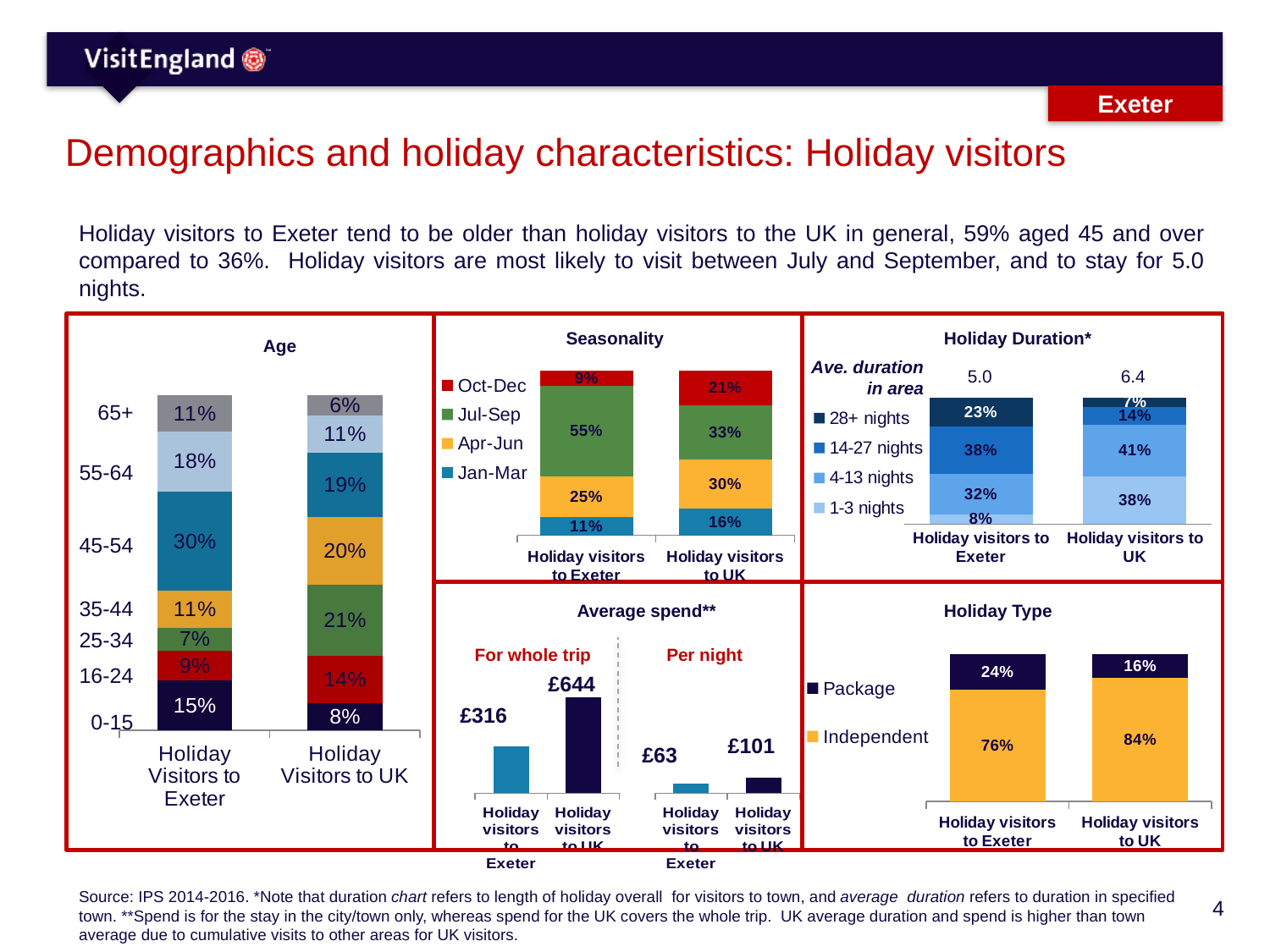
In the Holiday Duration chart, what is the average duration in area for holiday visitors to the UK? 6.4 In the Average spend chart, what is the average spend for the whole trip for holiday visitors to Exeter? £316 In the Average spend chart, what is the difference between the per night spend of holiday visitors to the UK and holiday visitors to Exeter? £38 In the Age chart, what share of holiday visitors to the UK are aged 25-34? 21% In the Age chart, which age group is the largest for holiday visitors to Exeter? 45-54 In the Holiday Type chart, what share of holiday visitors to Exeter are on a package holiday? 24% In the Holiday Duration chart, what share of holiday visitors to Exeter stay 14-27 nights? 38% In the Seasonality chart, what is the difference between the Jul-Sep share for holiday visitors to Exeter and for holiday visitors to the UK? 22% What type of chart is the Holiday Type chart? Stacked bar chart In the Seasonality chart, what share of holiday visitors to Exeter visit in Jul-Sep? 55% In the Age chart, what share of holiday visitors to Exeter are aged 45-54? 30% How many series does the legend of the Seasonality chart list? 4